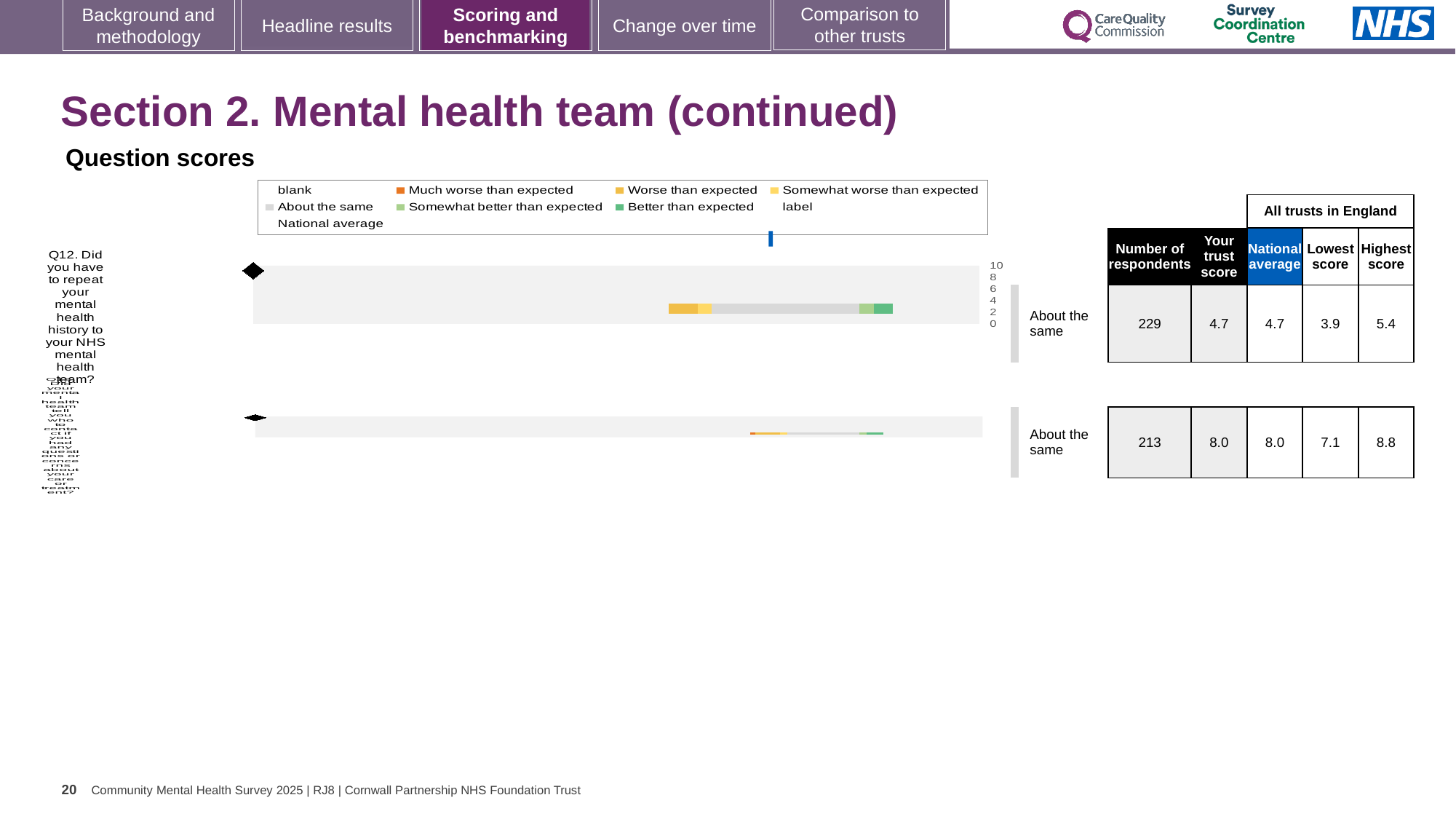
What benchmark rating is shown next to the Q12 chart? About the same In the Q12 chart, what is the highest score among all trusts in England? 5.4 In the Q12 chart, what is the difference between the highest and lowest scores for all trusts in England? 1.5 In the second (lower) chart, how many respondents are listed? 213 In the second (lower) chart, what is the difference between the highest score (8.8) and the lowest score (7.1)? 1.7 In the second (lower) chart, what is the trust's score? 8.0 In the Q12 chart, what is the lowest score among all trusts in England? 3.9 In the Q12 chart, how many respondents are listed? 229 In the Q12 chart (repeating mental health history), what is the trust's score shown in the table? 4.7 In the Q12 chart, is the trust score marker greater or less than 6 on the axis? less Which chart shows the higher trust score, the Q12 chart or the second (lower) chart? The second (lower) chart In the Q12 chart, what is the national average score? 4.7